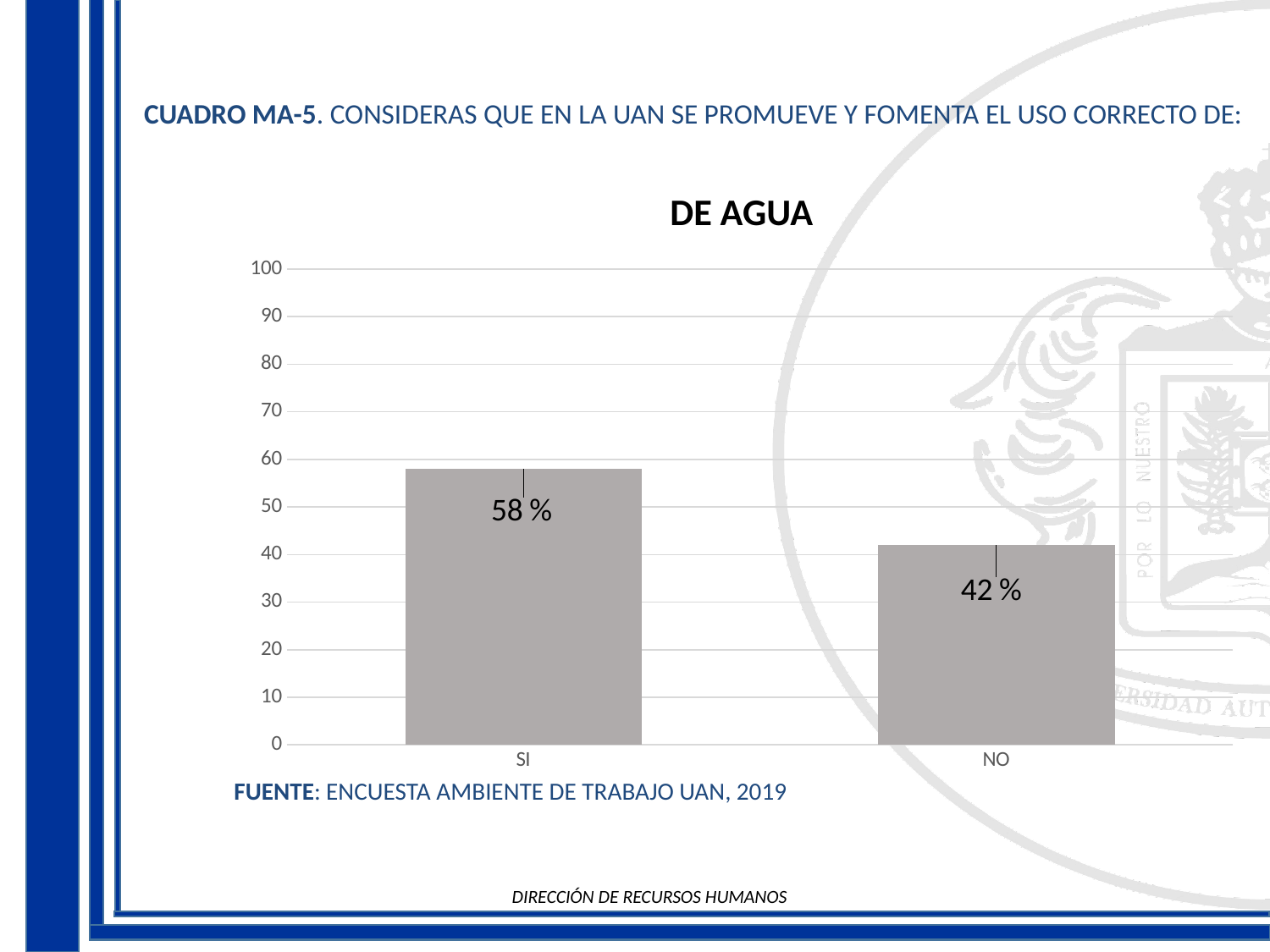
What kind of chart is shown? bar chart Is the value for SI greater or less than 50? greater Which category has the highest value? SI Which category has the lowest value? NO Which is larger, the value for SI or the value for NO? SI What is the difference between the values for SI and NO? 16 % What is the value for SI? 58 % What is the title of the chart? DE AGUA What is the value for NO? 42 % Is the value for NO greater or less than 50? less How many categories are shown on the x axis? 2 What is the maximum value shown on the y axis? 100